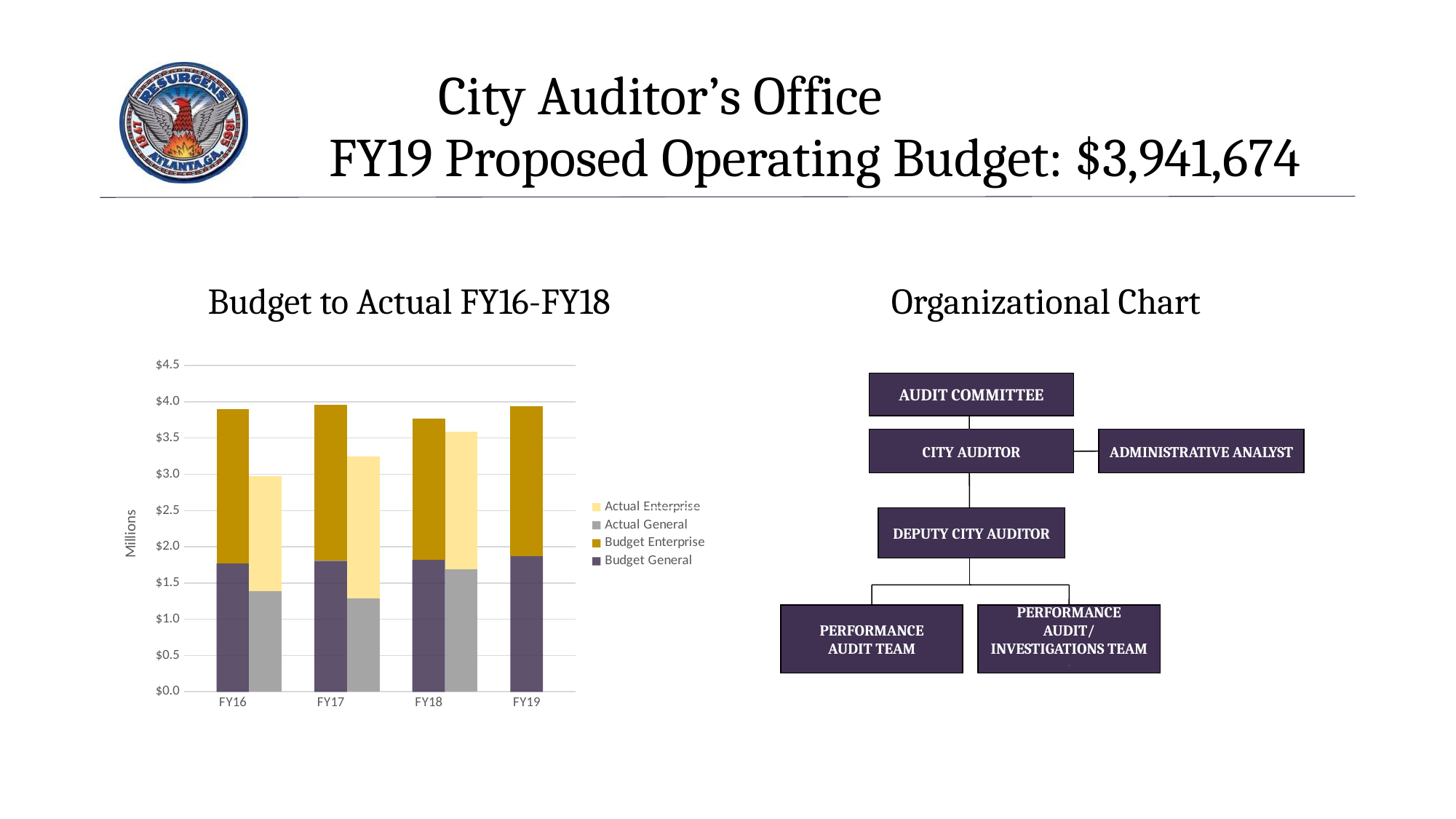
In the "Budget to Actual FY16-FY18" chart, what unit does the y axis label indicate? Millions How many fiscal years are shown on the x axis of the "Budget to Actual FY16-FY18" chart? 4 In the "Budget to Actual FY16-FY18" chart, do the total actual bars rise or fall from FY16 to FY18? rise In the "Budget to Actual FY16-FY18" chart, is the total budget bar for FY16 greater or less than $3.5? greater In the "Budget to Actual FY16-FY18" chart, is the Actual General value for FY18 greater or less than $1.5? greater In the "Budget to Actual FY16-FY18" chart, is the Actual General value for FY17 greater or less than $1.5? less In the "Budget to Actual FY16-FY18" chart, which is larger: the total actual bar for FY16 or the total actual bar for FY17? FY17 What kind of chart is the "Budget to Actual FY16-FY18" chart? Stacked bar chart In the "Budget to Actual FY16-FY18" chart, which fiscal year has only a budget bar and no actual bar? FY19 How many series does the legend of the "Budget to Actual FY16-FY18" chart list? 4